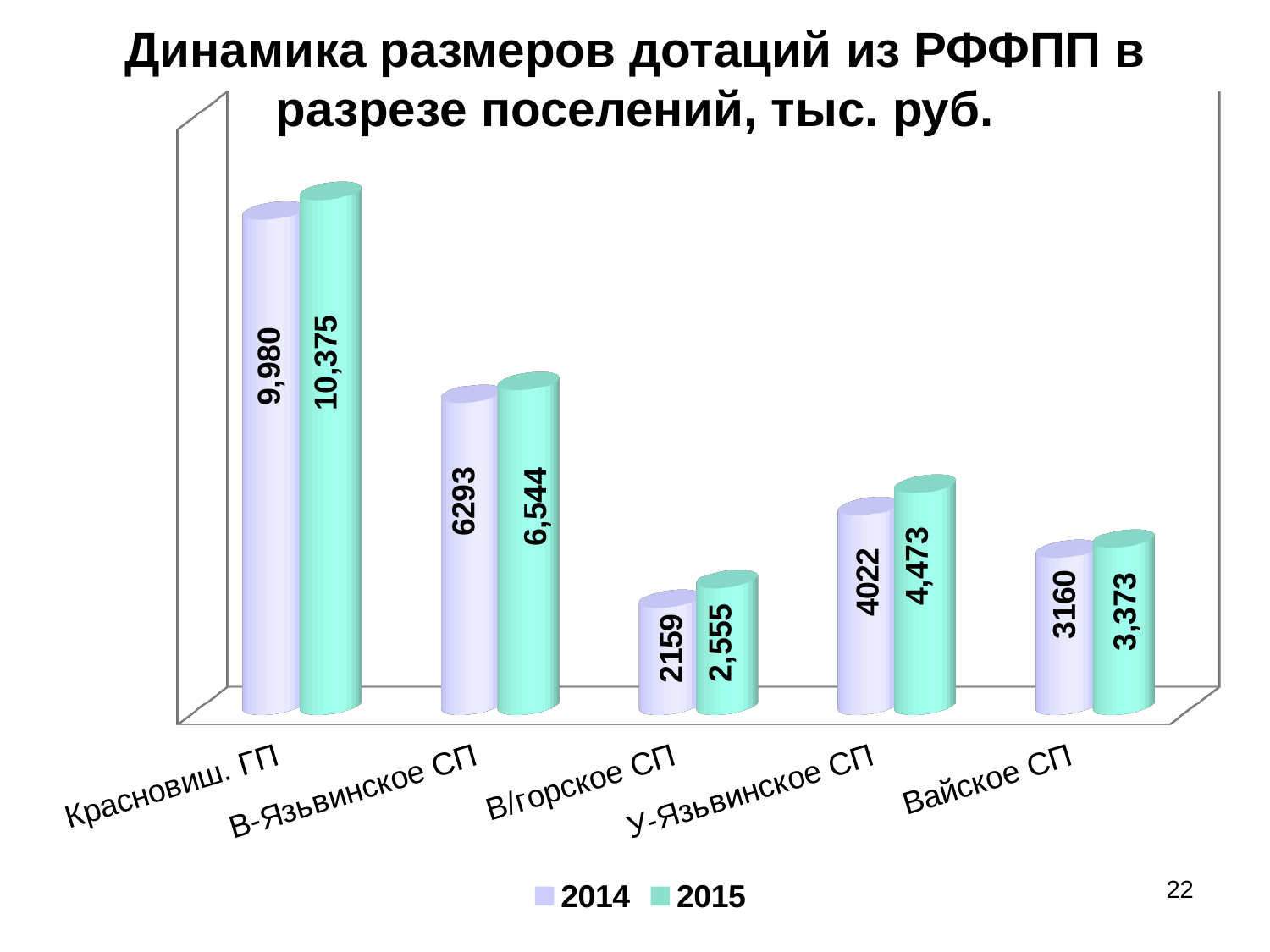
What is the difference between the 2015 and 2014 values for У-Язьвинское СП? 451 Which is larger: the 2014 value for У-Язьвинское СП or the 2015 value for Вайское СП? 2014 value for У-Язьвинское СП How many settlements are shown on the x axis? 5 What is the 2015 value for В-Язьвинское СП? 6,544 How many series does the legend list? 2 What is the 2014 value for В/горское СП? 2159 What is the 2014 value for Красновиш. ГП? 9,980 Which settlement has the highest 2015 value? Красновиш. ГП What is the 2014 value for Вайское СП? 3160 What is the difference between the 2015 and 2014 values for Красновиш. ГП? 395 What is the 2015 value for У-Язьвинское СП? 4,473 Which settlement has the lowest 2014 value? В/горское СП